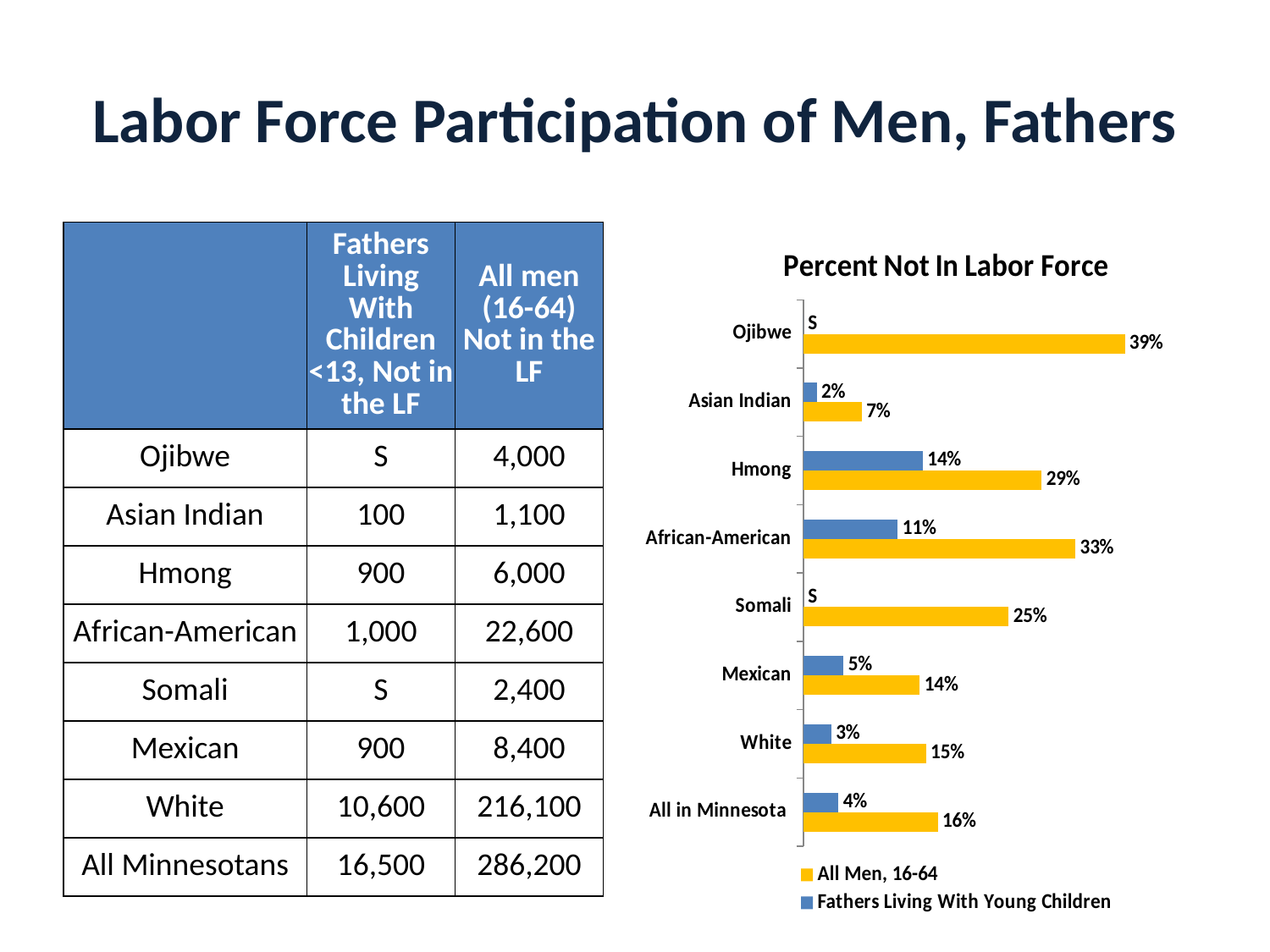
What is the value for All Men, 16-64 for African-American in the Percent Not In Labor Force chart? 33% How many series does the legend of the Percent Not In Labor Force chart list? 2 What label is shown instead of a value for the Fathers Living With Young Children series for Somali in the Percent Not In Labor Force chart? S What kind of chart is the Percent Not In Labor Force chart? Bar chart What is the difference between the All Men, 16-64 value and the Fathers Living With Young Children value for Hmong in the Percent Not In Labor Force chart? 15% What is the value for All Men, 16-64 for Ojibwe in the Percent Not In Labor Force chart? 39% What is the value for Fathers Living With Young Children for Hmong in the Percent Not In Labor Force chart? 14% What is the value for Fathers Living With Young Children for White in the Percent Not In Labor Force chart? 3% Which category has the lowest value for All Men, 16-64 in the Percent Not In Labor Force chart? Asian Indian How many categories are shown in the Percent Not In Labor Force chart? 8 Which category has the highest value for All Men, 16-64 in the Percent Not In Labor Force chart? Ojibwe In the Percent Not In Labor Force chart, which is larger for Mexican: the All Men, 16-64 value or the Fathers Living With Young Children value? All Men, 16-64